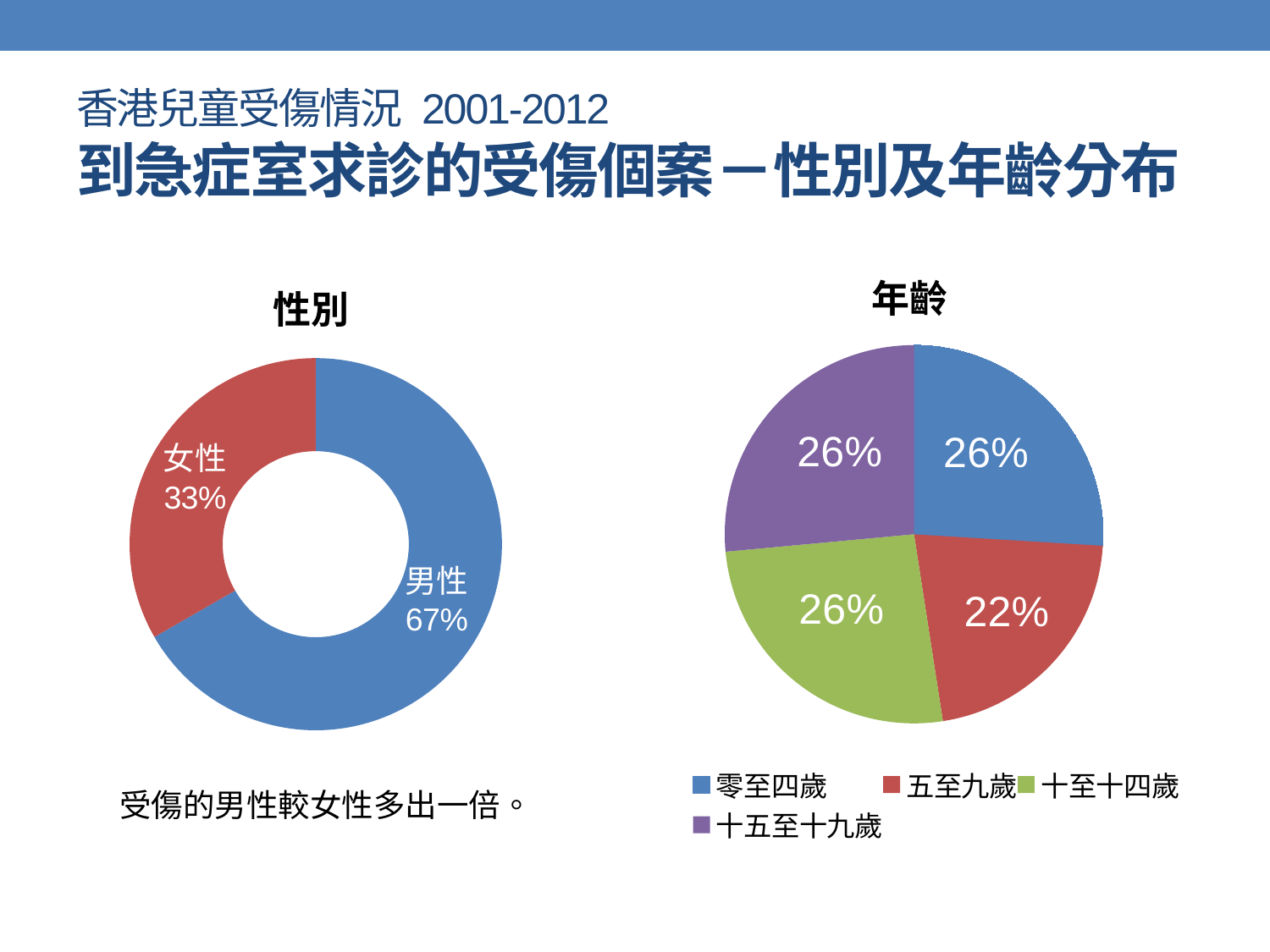
What kind of chart is the 年齡 chart? Pie chart In the 性別 chart, what is the difference in percentage points between 男性 and 女性? 34 In the 年齡 chart, what colour represents 十五至十九歲? Purple In the 年齡 chart, which age group has the smallest share? 五至九歲 In the 年齡 chart, what percentage is 五至九歲? 22% In the 年齡 chart, what percentage is 零至四歲? 26% In the 年齡 chart, which is larger: 零至四歲 or 五至九歲? 零至四歲 In the 性別 chart, what percentage is 男性? 67% What kind of chart is the 性別 chart? Doughnut chart In the 性別 chart, what percentage is 女性? 33% In the 性別 chart, which category has the larger share? 男性 How many categories does the 年齡 chart's legend list? 4